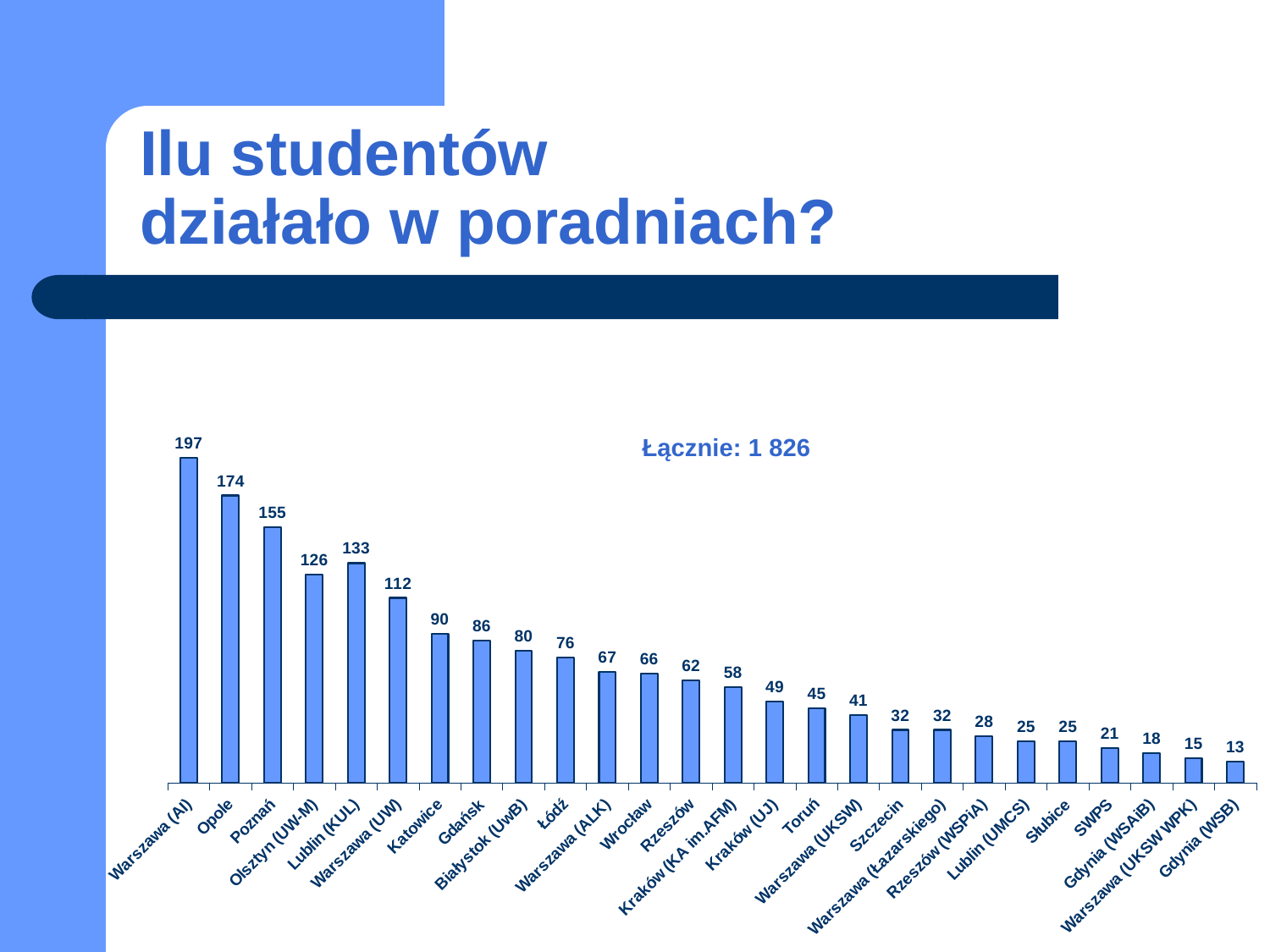
Which is larger, the value for Olsztyn (UW-M) or the value for Lublin (KUL)? Lublin (KUL) Which category has the lowest value? Gdynia (WSB) What is the value for Lublin (KUL)? 133 What is the value for Kraków (UJ)? 49 How many students are shown for Warszawa (AI)? 197 What is the difference between the values for Opole and Poznań? 19 How many categories are plotted on the chart? 26 Which category has the highest value? Warszawa (AI) What kind of chart is shown on the slide? bar chart Do the values generally rise or fall from left to right along the x axis? fall What total number of students is stated on the chart (Łącznie)? 1 826 What is the difference between the values for Katowice and Gdańsk? 4